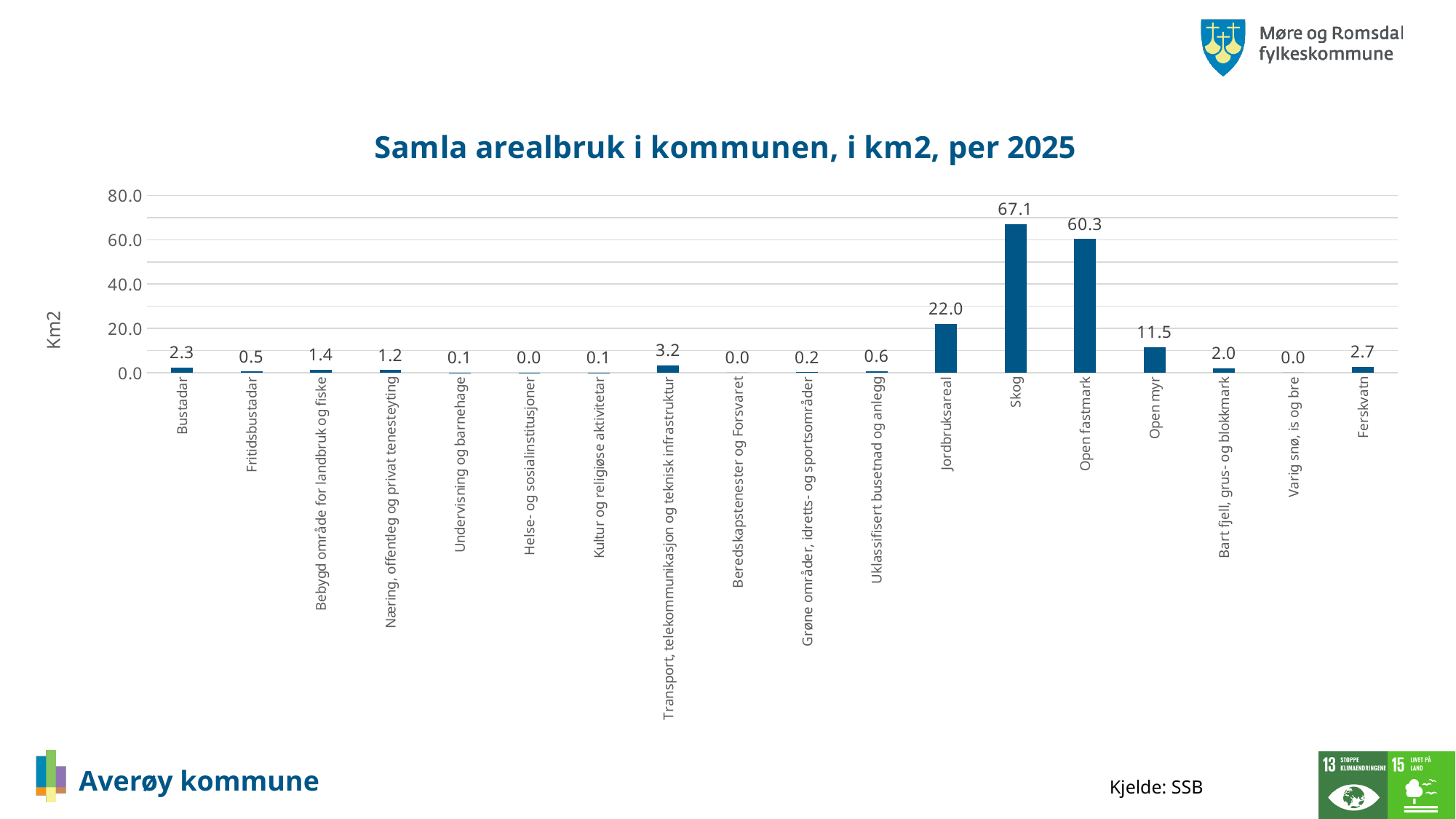
Is the value for Open myr greater or less than 20.0? less What is the value for Ferskvatn? 2.7 Which category has the highest value? Skog What is the value for Skog? 67.1 What kind of chart is shown on the slide? bar chart What is the difference between the values for Skog and Open fastmark? 6.8 How many categories are shown on the x axis? 18 What is the value for Jordbruksareal? 22.0 What is the title of the chart? Samla arealbruk i kommunen, i km2, per 2025 What is the difference between the values for Jordbruksareal and Open myr? 10.5 What is the value for Open fastmark? 60.3 Which is larger, the value for Bustadar or the value for Transport, telekommunikasjon og teknisk infrastruktur? Transport, telekommunikasjon og teknisk infrastruktur